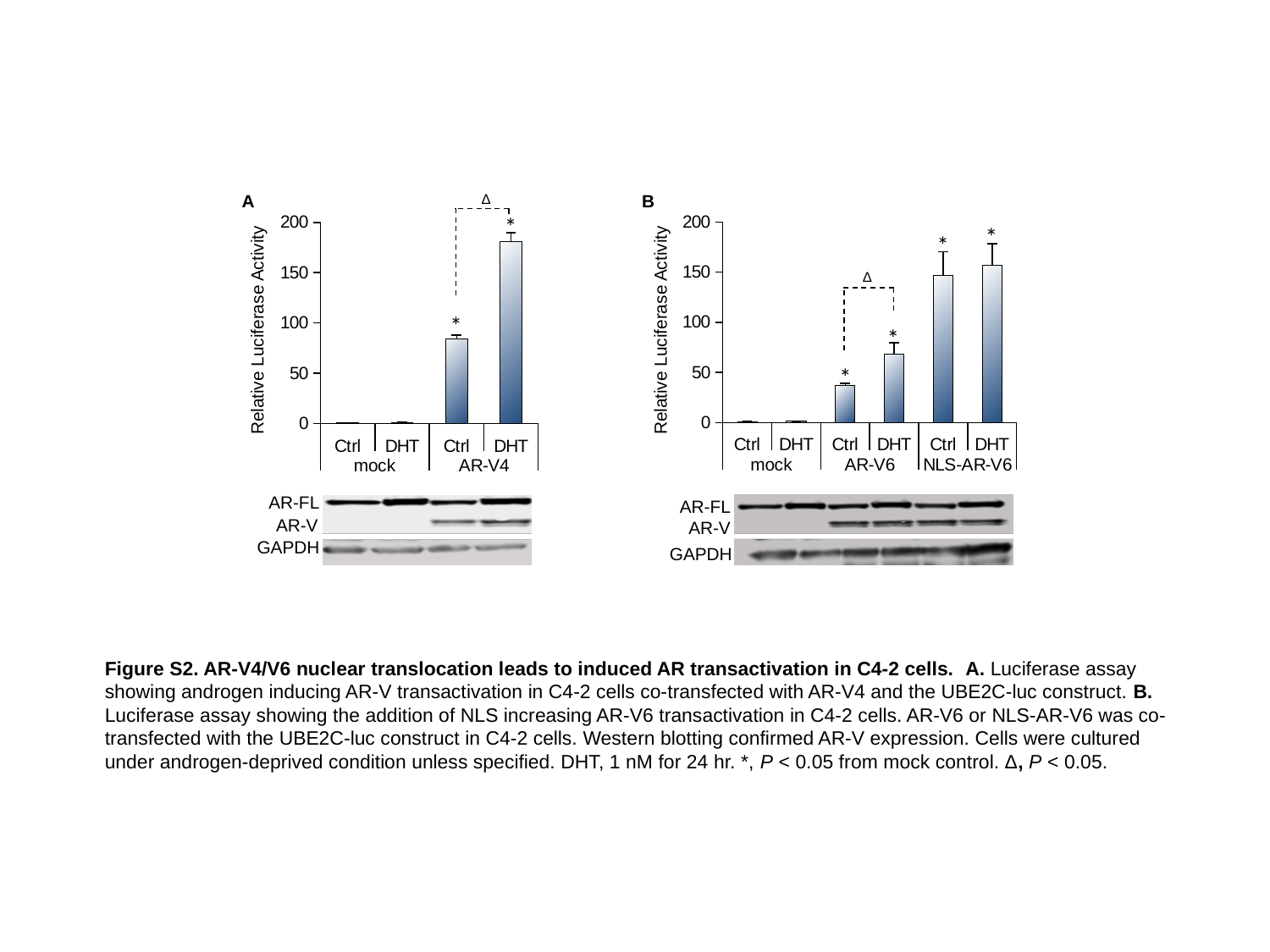
In chart B (right), is the value for NLS-AR-V6 DHT greater or less than 100? greater In chart A (left), which is larger, AR-V4 Ctrl or AR-V4 DHT? AR-V4 DHT In chart A (left), how many bars are plotted? 4 In chart A (left), which bar is the highest? AR-V4 DHT In chart A (left), what kind of chart is shown? bar chart In chart B (right), what is the label of the y axis? Relative Luciferase Activity In chart A (left), is the value for AR-V4 Ctrl greater or less than 100? less In chart B (right), is the value for AR-V6 Ctrl greater or less than 50? less In chart B (right), how many bars are plotted? 6 In chart B (right), which is larger, AR-V6 DHT or NLS-AR-V6 Ctrl? NLS-AR-V6 Ctrl